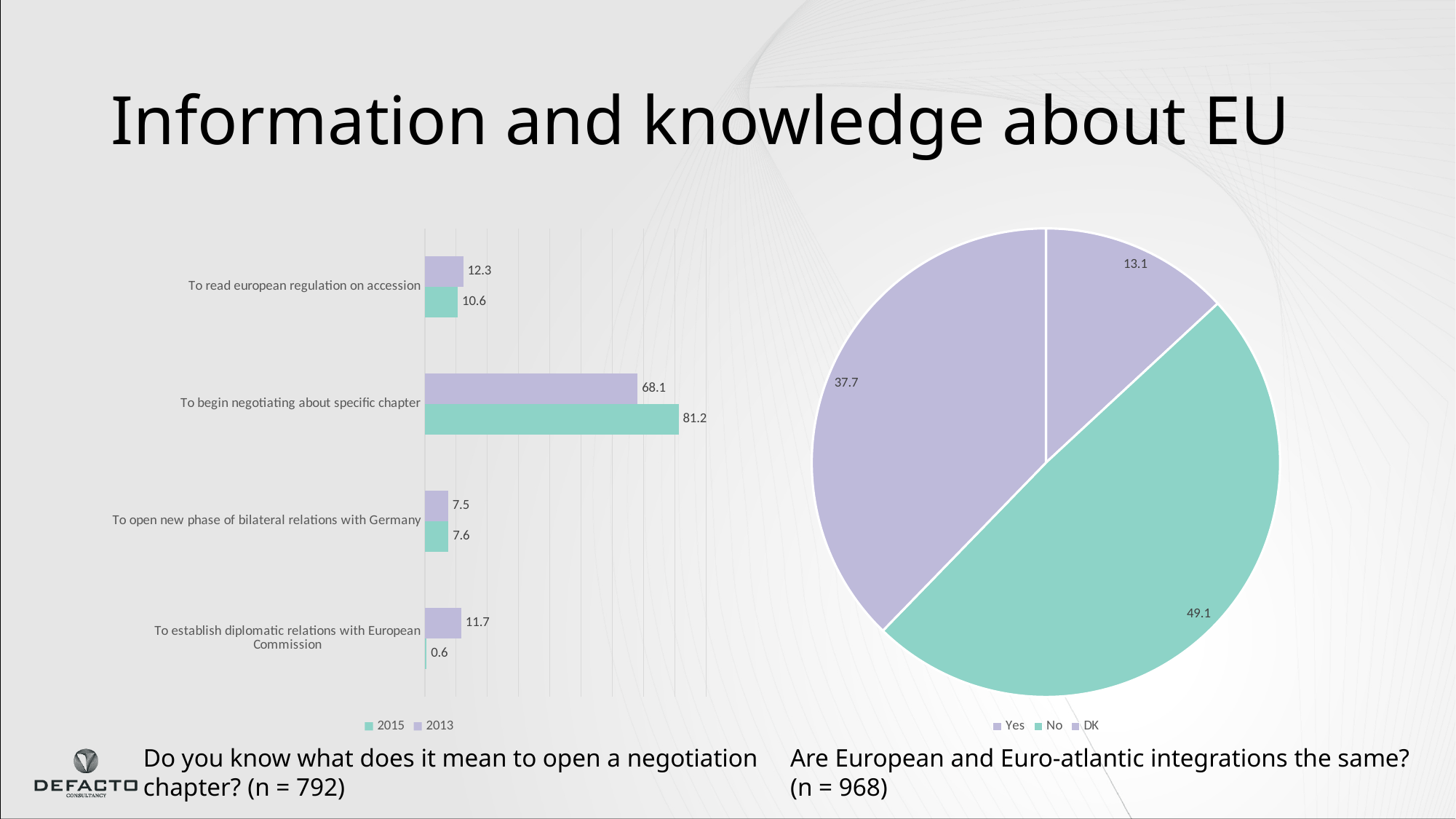
In the pie chart on the right, which response has the largest slice? No In the bar chart on the left, which category has the highest 2013 value? To begin negotiating about specific chapter In the bar chart on the left, what is the 2013 value for 'To read european regulation on accession'? 12.3 How many categories does the bar chart on the left show? 4 What kind of chart is on the right side of the slide? Pie chart In the bar chart on the left, which category has the lowest 2015 value? To establish diplomatic relations with European Commission In the bar chart on the left, what is the difference between the 2015 and 2013 values for 'To begin negotiating about specific chapter'? 13.1 In the bar chart on the left, what is the 2015 value for 'To establish diplomatic relations with European Commission'? 0.6 How many series does the legend of the bar chart on the left list? 2 In the bar chart on the left, is the 2013 value for 'To establish diplomatic relations with European Commission' larger or smaller than the 2015 value? larger In the bar chart on the left, what is the 2015 value for 'To begin negotiating about specific chapter'? 81.2 In the pie chart on the right, what is the value of the 'No' slice? 49.1